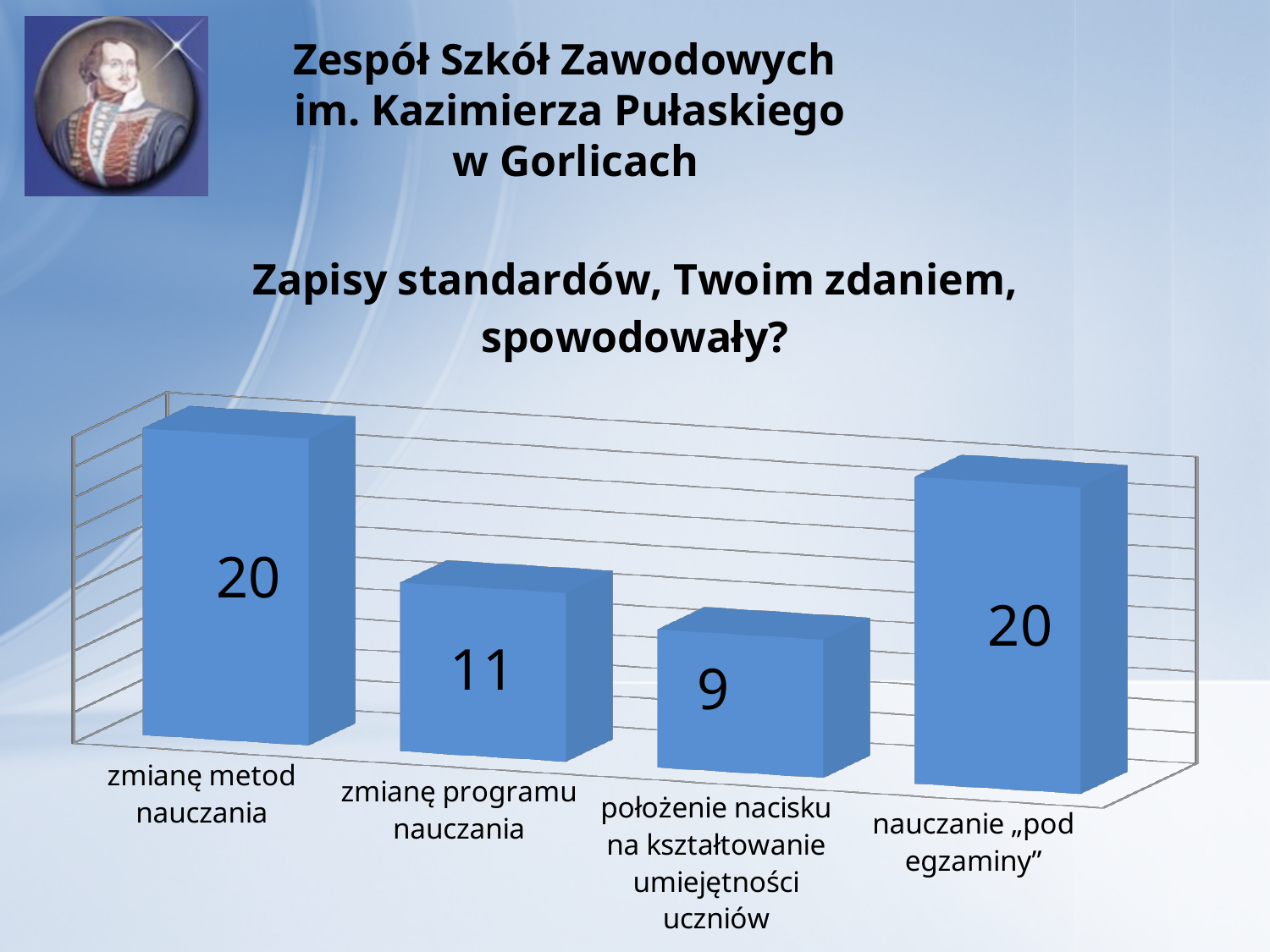
What is the value for "zmianę programu nauczania"? 11 What is the difference between the values for "zmianę programu nauczania" and "położenie nacisku na kształtowanie umiejętności uczniów"? 2 What is the value for "położenie nacisku na kształtowanie umiejętności uczniów"? 9 What is the difference between the values for "zmianę metod nauczania" and "zmianę programu nauczania"? 9 What is the value for "nauczanie „pod egzaminy”"? 20 What is the title of the chart? Zapisy standardów, Twoim zdaniem, spowodowały? What is the value for "zmianę metod nauczania"? 20 What kind of chart is shown on the slide? bar chart How many categories are shown in the chart? 4 Do the values rise or fall from the first category to the third category along the x axis? fall Which category has the lowest value? położenie nacisku na kształtowanie umiejętności uczniów Which is larger: the value for "zmianę programu nauczania" or the value for "nauczanie „pod egzaminy”"? nauczanie „pod egzaminy”